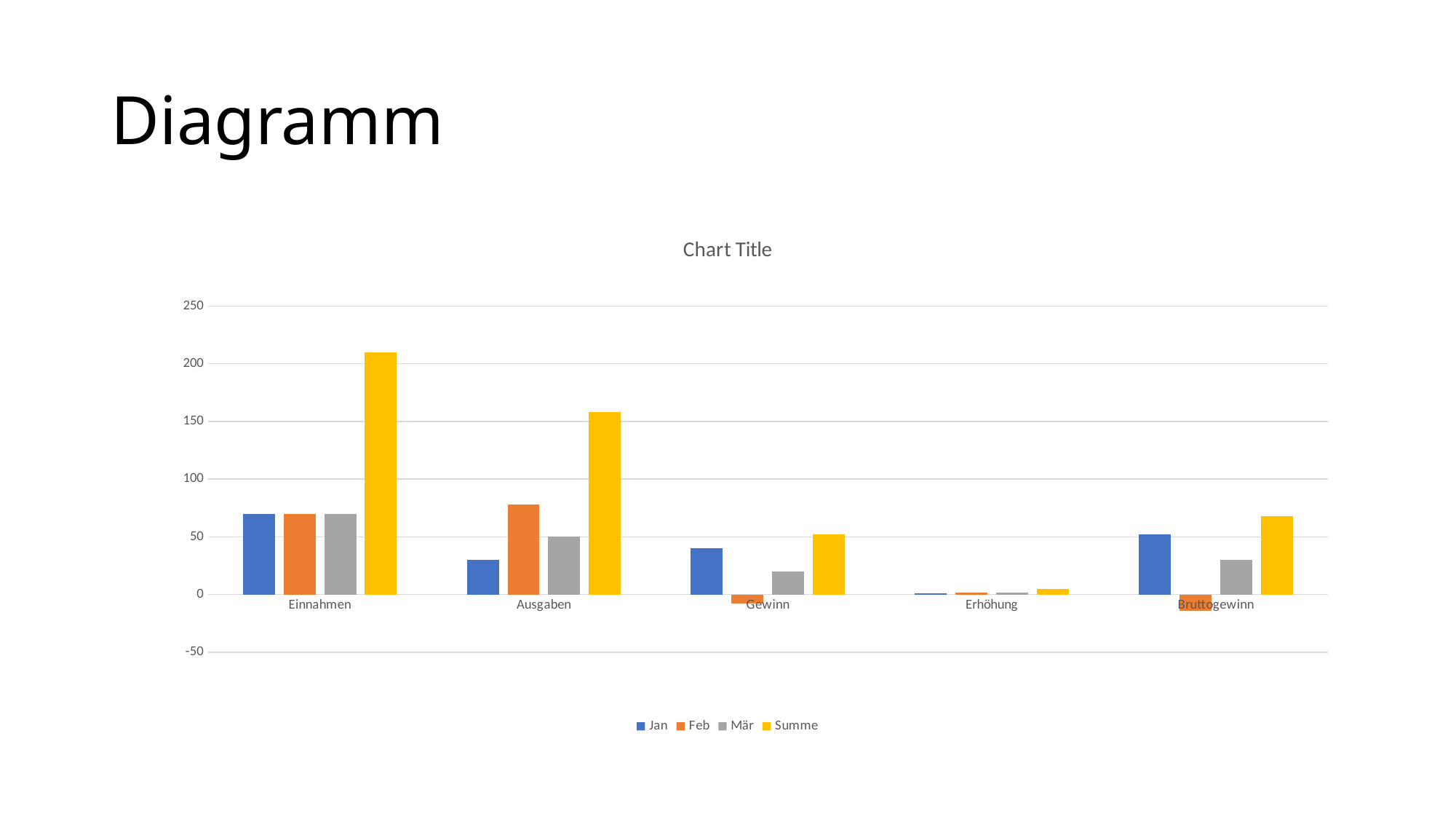
Which category has the highest Summe value? Einnahmen Is the Summe value for Einnahmen greater or less than 200? greater Is the Feb value for Gewinn greater or less than 0? less Is the Summe value for Ausgaben greater or less than 150? greater How many categories are shown on the x axis of the chart? 5 Which category has the lowest Summe value? Erhöhung How many series does the chart's legend list? 4 What kind of chart is shown on the slide? bar chart Which is larger: the Summe value for Gewinn or the Summe value for Bruttogewinn? Bruttogewinn For Ausgaben, which is larger: the Jan value or the Feb value? Feb What is the title shown above the chart? Chart Title